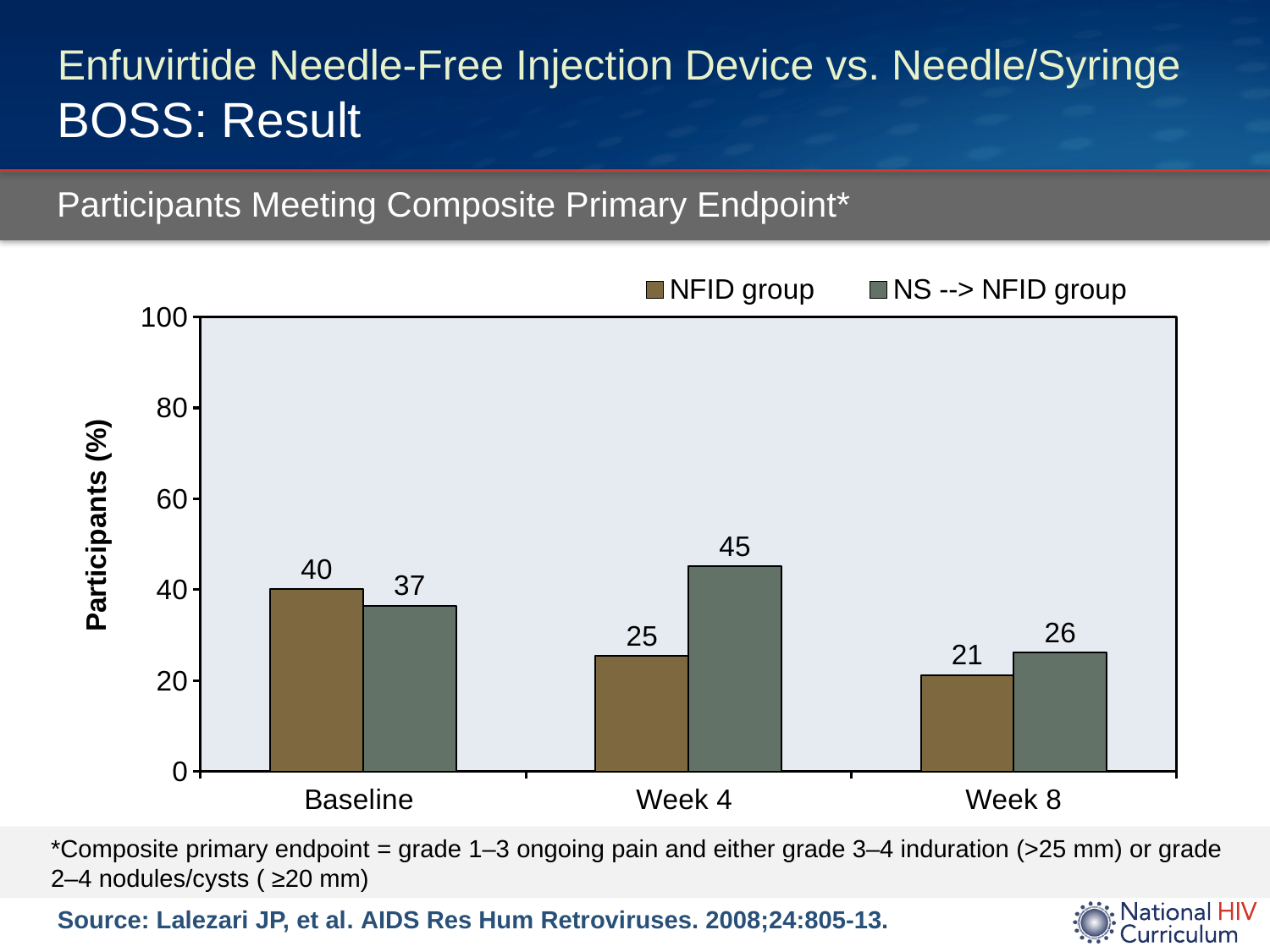
How many series does the legend list? 2 How many time points are shown on the x axis? 3 Which group has the larger value at Baseline, NFID group or NS --> NFID group? NFID group At which time point is the NS --> NFID group value highest? Week 4 What kind of chart is shown on the slide? bar chart Do the NFID group values rise or fall from Baseline to Week 8? fall What is the difference between the NS --> NFID group and the NFID group at Week 4? 20 What is the value for the NFID group at Week 8? 21 At which time point is the NFID group value lowest? Week 8 What is the value for the NS --> NFID group at Week 4? 45 Is the value for the NS --> NFID group at Baseline greater or less than 20? greater What percentage of participants in the NFID group met the composite primary endpoint at Baseline? 40